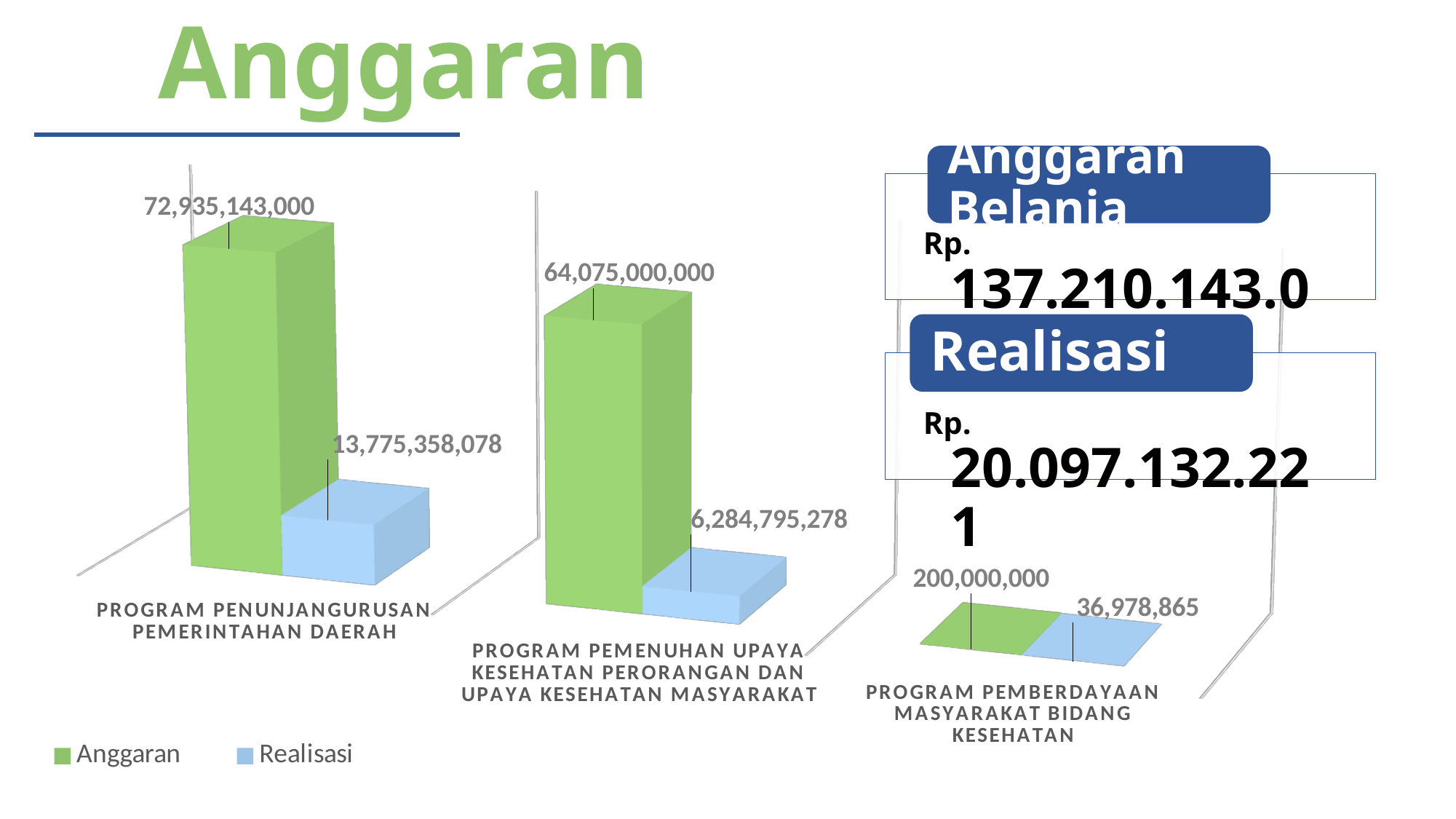
What is the difference between Anggaran and Realisasi for Program Penunjang Urusan Pemerintahan Daerah? 59,159,784,922 What is the Anggaran value for Program Penunjang Urusan Pemerintahan Daerah? 72,935,143,000 What type of chart is shown on the slide? Bar chart How many series does the chart legend list? 2 What is the Realisasi value for Program Pemberdayaan Masyarakat Bidang Kesehatan? 36,978,865 What is the Anggaran value for Program Pemenuhan Upaya Kesehatan Perorangan dan Upaya Kesehatan Masyarakat? 64,075,000,000 How many programs (categories) are shown in the chart? 3 Which is larger: the Realisasi for Program Penunjang Urusan Pemerintahan Daerah or the Realisasi for Program Pemenuhan Upaya Kesehatan Perorangan dan Upaya Kesehatan Masyarakat? Program Penunjang Urusan Pemerintahan Daerah Which program has the lowest Realisasi value? Program Pemberdayaan Masyarakat Bidang Kesehatan What is the Realisasi value for Program Penunjang Urusan Pemerintahan Daerah? 13,775,358,078 Which program has the highest Anggaran value? Program Penunjang Urusan Pemerintahan Daerah What is the difference between Anggaran and Realisasi for Program Pemberdayaan Masyarakat Bidang Kesehatan? 163,021,135